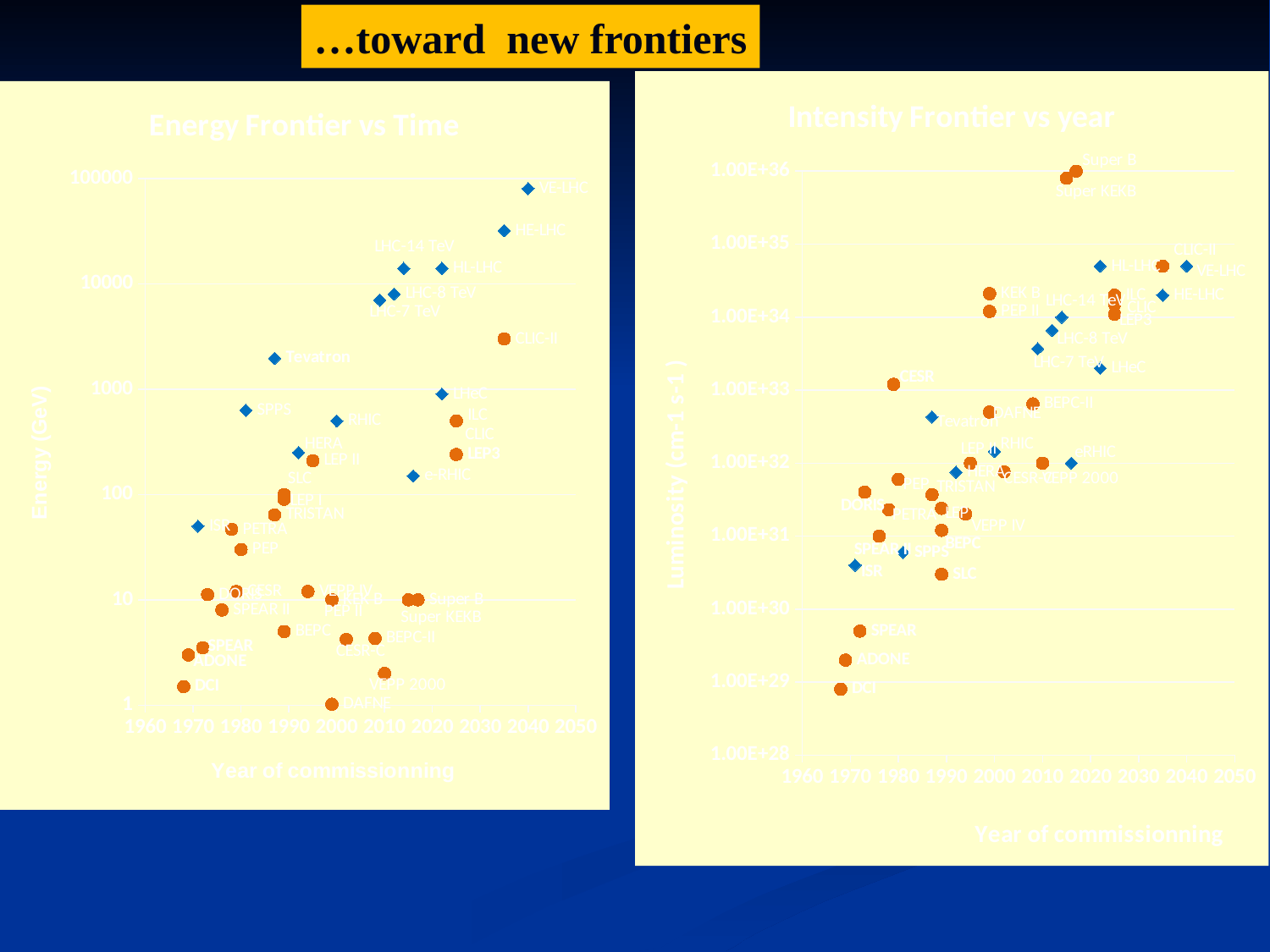
What kind of chart is the "Intensity Frontier vs year" chart? scatter chart In the "Intensity Frontier vs year" chart, is the luminosity for SPEAR greater or less than 1.00E+31? less In the "Energy Frontier vs Time" chart, which labelled point has the lowest energy? DAFNE In the "Energy Frontier vs Time" chart, is the energy for VE-LHC greater or less than 10000? greater In the "Energy Frontier vs Time" chart, is the energy for Tevatron greater or less than 1000? greater In the "Energy Frontier vs Time" chart, which labelled point has the highest energy? VE-LHC In the "Energy Frontier vs Time" chart, which has the higher energy, Tevatron or SPPS? Tevatron What is the x-axis label of the "Energy Frontier vs Time" chart? Year of commissionning In the "Intensity Frontier vs year" chart, do luminosity values generally rise or fall as the year of commissioning increases? rise What kind of chart is the "Energy Frontier vs Time" chart? scatter chart In the "Intensity Frontier vs year" chart, which labelled point has the lowest luminosity? DCI